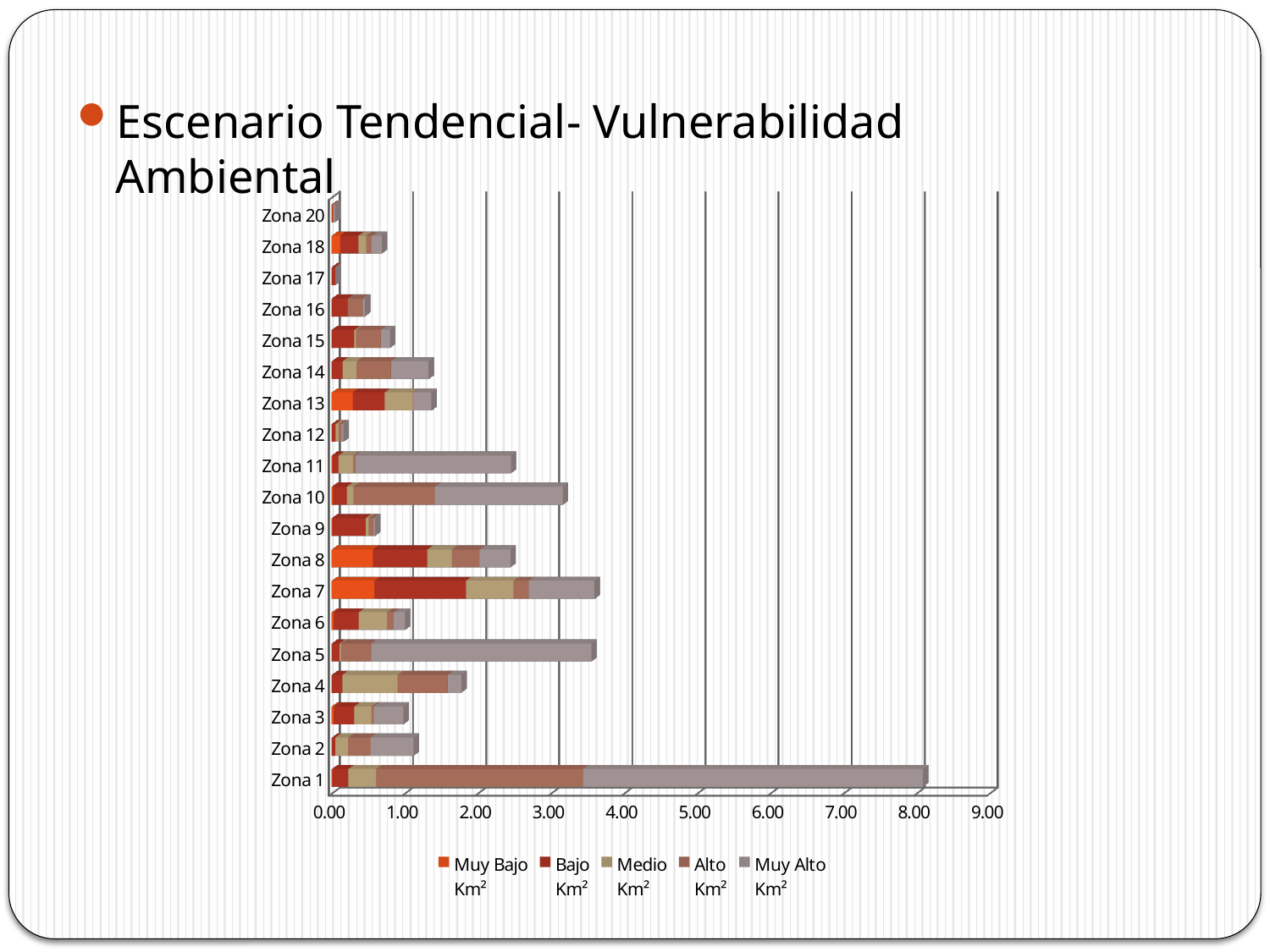
Which has the longer total bar, Zona 7 or Zona 8? Zona 7 Is the total bar length for Zona 9 greater or less than 1.00? less Which zone has the longest total bar? Zona 1 Is the total bar length for Zona 4 greater or less than 1.00? greater Is the total bar length for Zona 5 greater or less than 3.00? greater Which has the longer total bar, Zona 5 or Zona 11? Zona 5 How many series does the legend list? 5 Which legend entry is shown in orange? Muy Bajo Km² What kind of chart is shown on the slide? Bar chart How many zones (categories) are plotted on the chart? 19